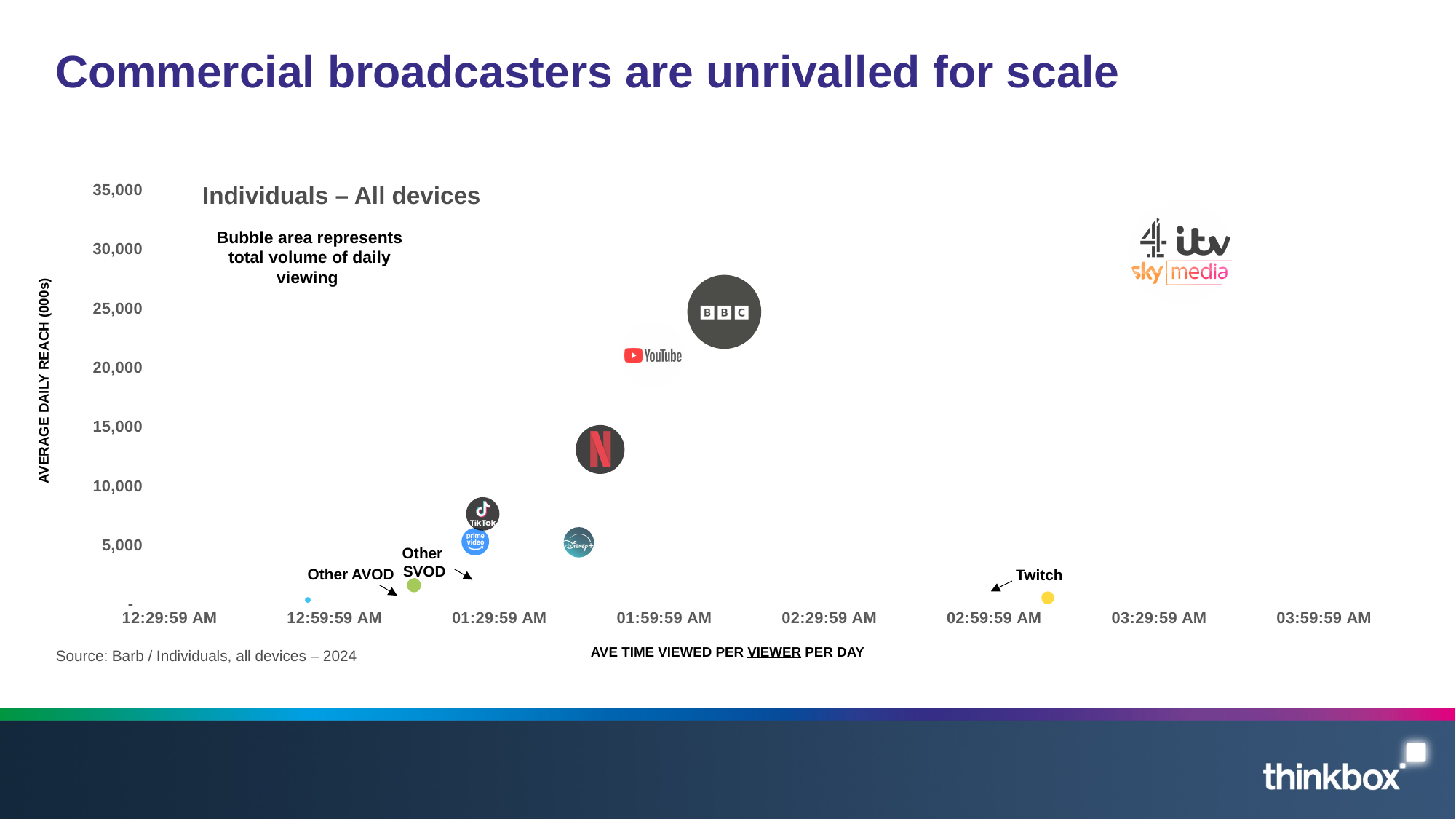
Is the average daily reach for Netflix greater or less than 15,000? less What is the label on the vertical axis of the chart? AVERAGE DAILY REACH (000s) What kind of chart is shown on the slide? bubble chart Is the average daily reach for Netflix greater or less than 10,000? greater Is the average daily reach for BBC greater or less than 20,000? greater According to the chart note, what does the bubble area represent? total volume of daily viewing Which has the longer average time viewed per viewer per day, Twitch or BBC? Twitch Which has the higher average daily reach, Netflix or TikTok? Netflix Which has the higher average daily reach, BBC or YouTube? BBC